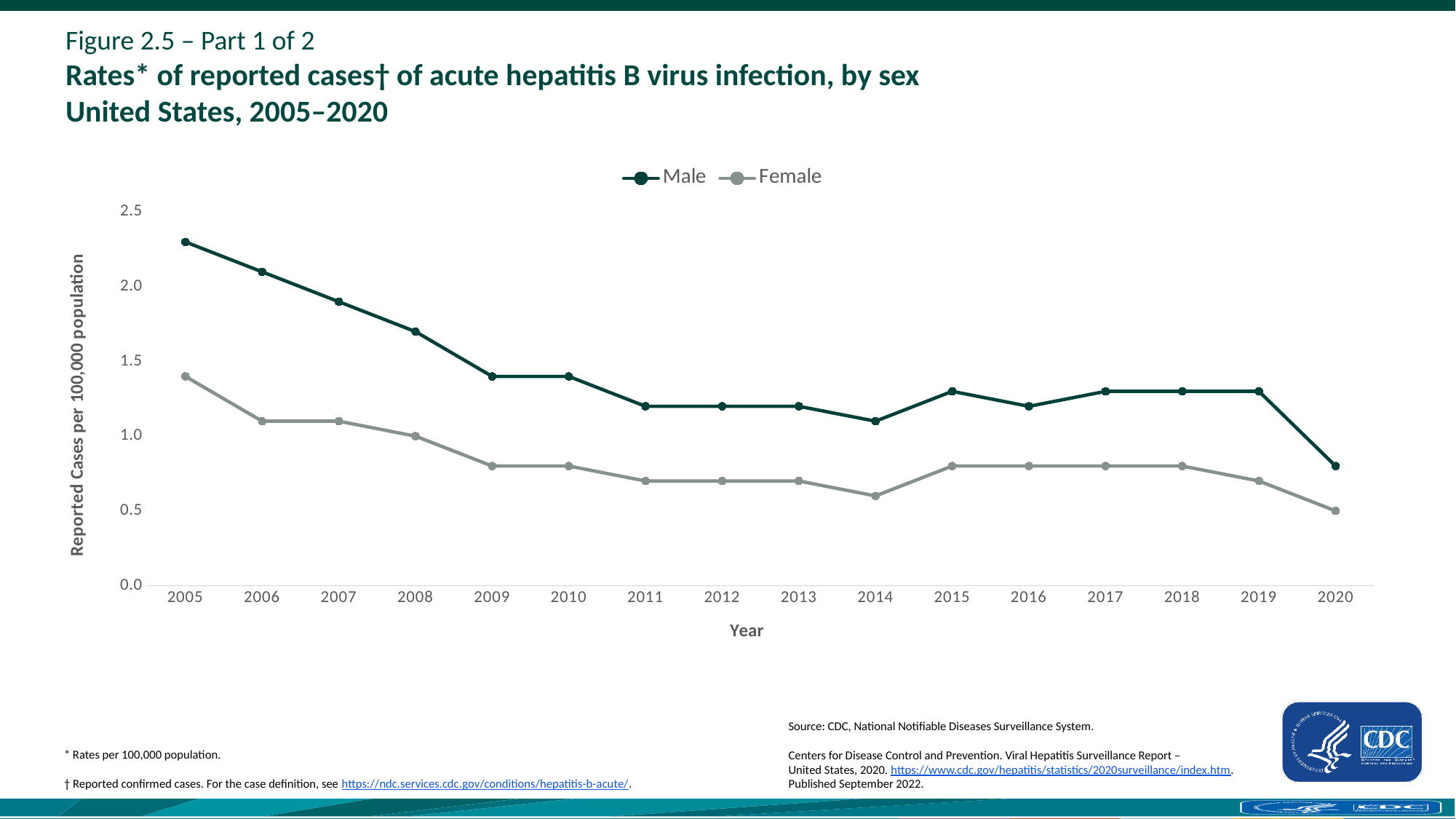
Is the Male rate in 2005 greater or less than 2.0? greater Is the Female rate in 2005 greater or less than 1.5? less Does the Male rate rise or fall from 2005 to 2009? fall How many years are plotted along the x axis? 16 Is the Male rate in 2020 greater or less than 1.0? less In which year is the Female rate lowest? 2020 In 2010, which series has the higher rate, Male or Female? Male In which year is the Male rate highest? 2005 In which year is the Male rate lowest? 2020 What is the label on the y axis? Reported Cases per 100,000 population How many series does the legend list? 2 What kind of chart is shown on the slide? line chart